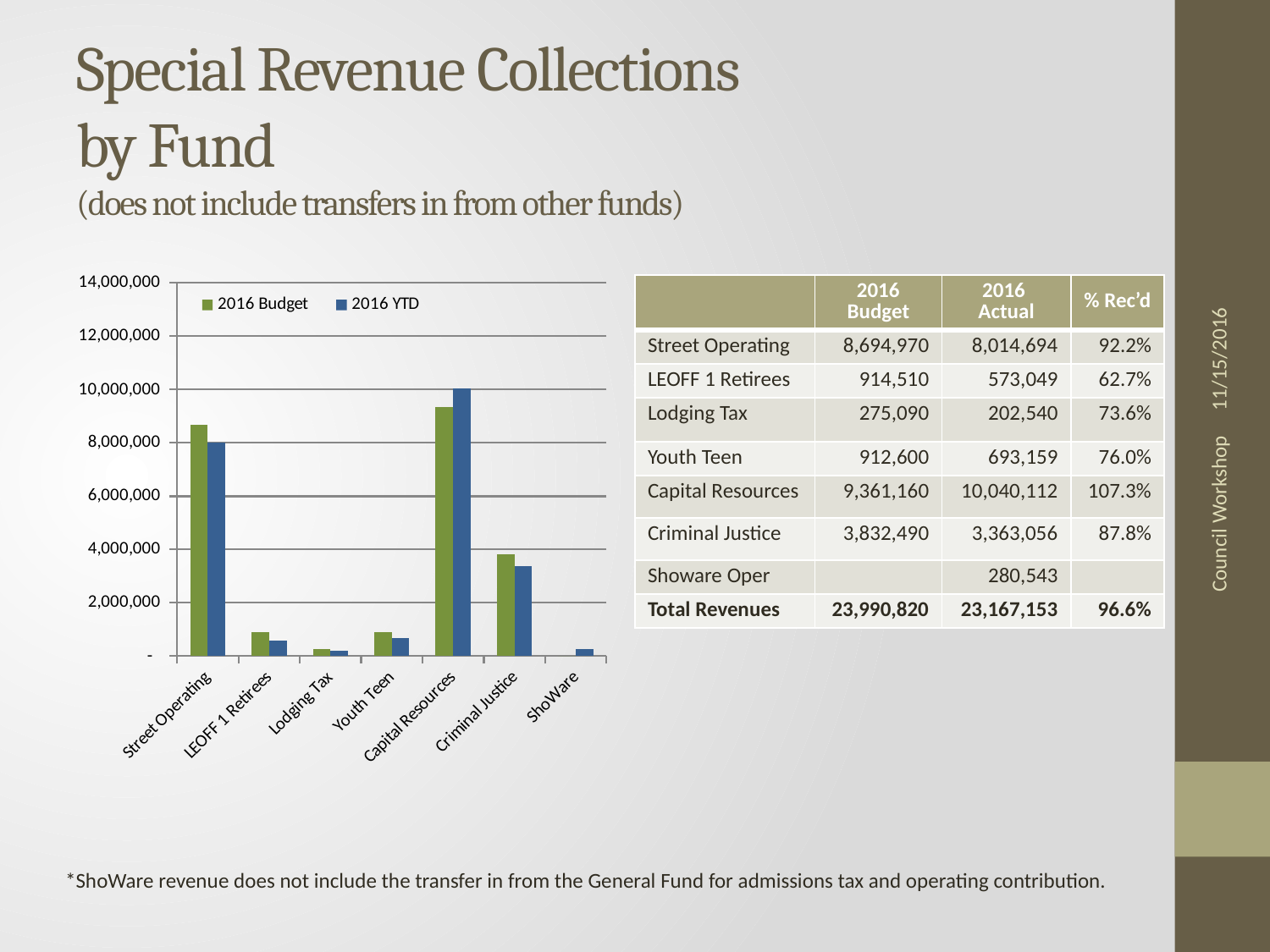
Is the 2016 YTD value for Criminal Justice greater or less than 4,000,000? less Which fund has the tallest 2016 YTD bar in the chart? Capital Resources According to the table, what is the % Rec'd for Capital Resources? 107.3% How many fund categories are shown on the chart's x axis? 7 Is the 2016 Budget value for Street Operating greater or less than 8,000,000? greater What kind of chart is shown on the slide? Bar chart What are the two legend entries in the chart? 2016 Budget and 2016 YTD Using the table values, how much larger is the 2016 Actual than the 2016 Budget for Capital Resources? 678,952 For Street Operating, which bar is taller: 2016 Budget or 2016 YTD? 2016 Budget For Capital Resources, which bar is taller: 2016 Budget or 2016 YTD? 2016 YTD How many series does the chart's legend list? 2 According to the table, what is the 2016 Budget for Street Operating? 8,694,970